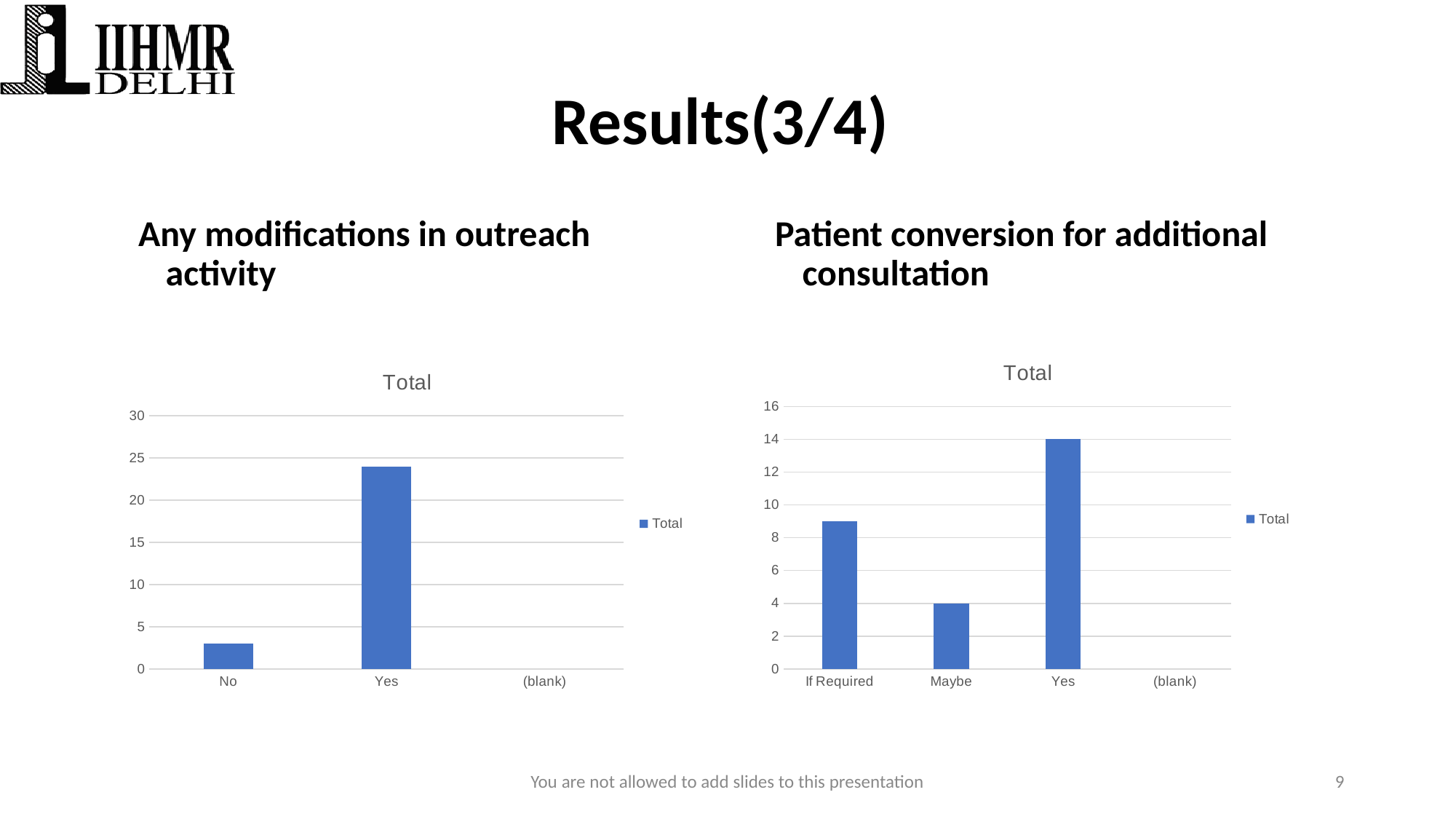
In the 'Any modifications in outreach activity' chart, how many categories are shown on the x axis? 3 In the 'Any modifications in outreach activity' chart, is the value for Yes greater or less than 20? greater In the 'Any modifications in outreach activity' chart, which category has the highest value? Yes What kind of chart is the 'Patient conversion for additional consultation' chart? bar chart In the 'Patient conversion for additional consultation' chart, what is the value for Yes? 14 In the 'Any modifications in outreach activity' chart, is the value for No greater or less than 5? less In the 'Patient conversion for additional consultation' chart, which category has the highest value? Yes In the 'Any modifications in outreach activity' chart, how many series does the legend list? 1 In the 'Patient conversion for additional consultation' chart, what is the value for Maybe? 4 In the 'Patient conversion for additional consultation' chart, is the value for If Required greater or less than 8? greater In the 'Patient conversion for additional consultation' chart, which is larger, the value for If Required or the value for Maybe? If Required In the 'Patient conversion for additional consultation' chart, what is the difference between the values for Yes and Maybe? 10